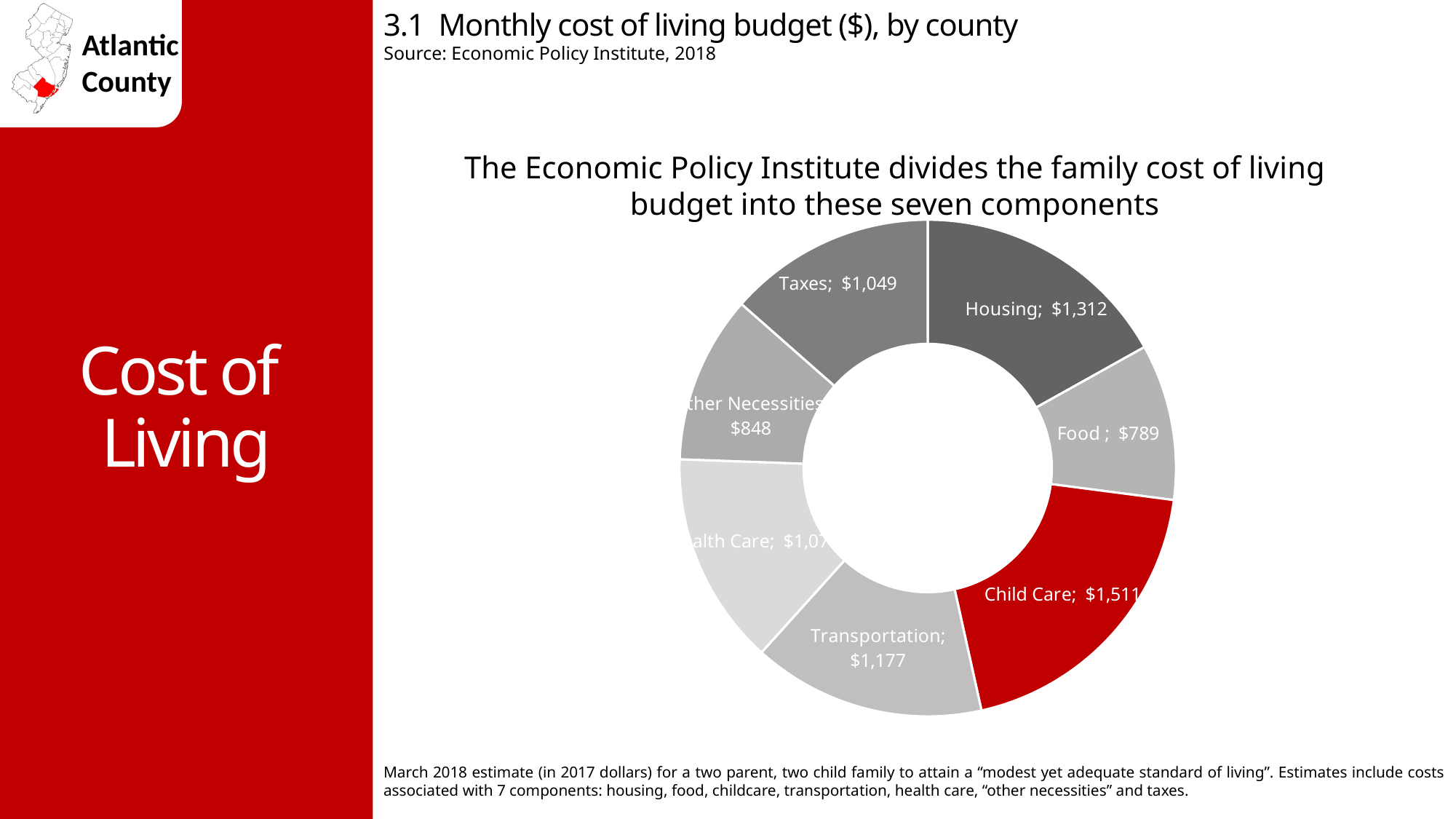
Which component has the highest monthly cost? Child Care What type of chart is shown on the slide? Doughnut (pie) chart How much more is the monthly cost of Child Care than Housing? $199 What is the monthly cost of Food shown on the chart? $789 What is the monthly cost of Taxes shown on the chart? $1,049 Which component has the lowest monthly cost? Food What is the monthly cost of Child Care shown on the chart? $1,511 Which is larger, the monthly cost of Housing or Transportation? Housing How many components are shown in the chart? 7 What is the monthly cost of Transportation shown on the chart? $1,177 What is the difference between the monthly cost of Housing and Food? $523 What is the monthly cost of Housing shown on the chart? $1,312